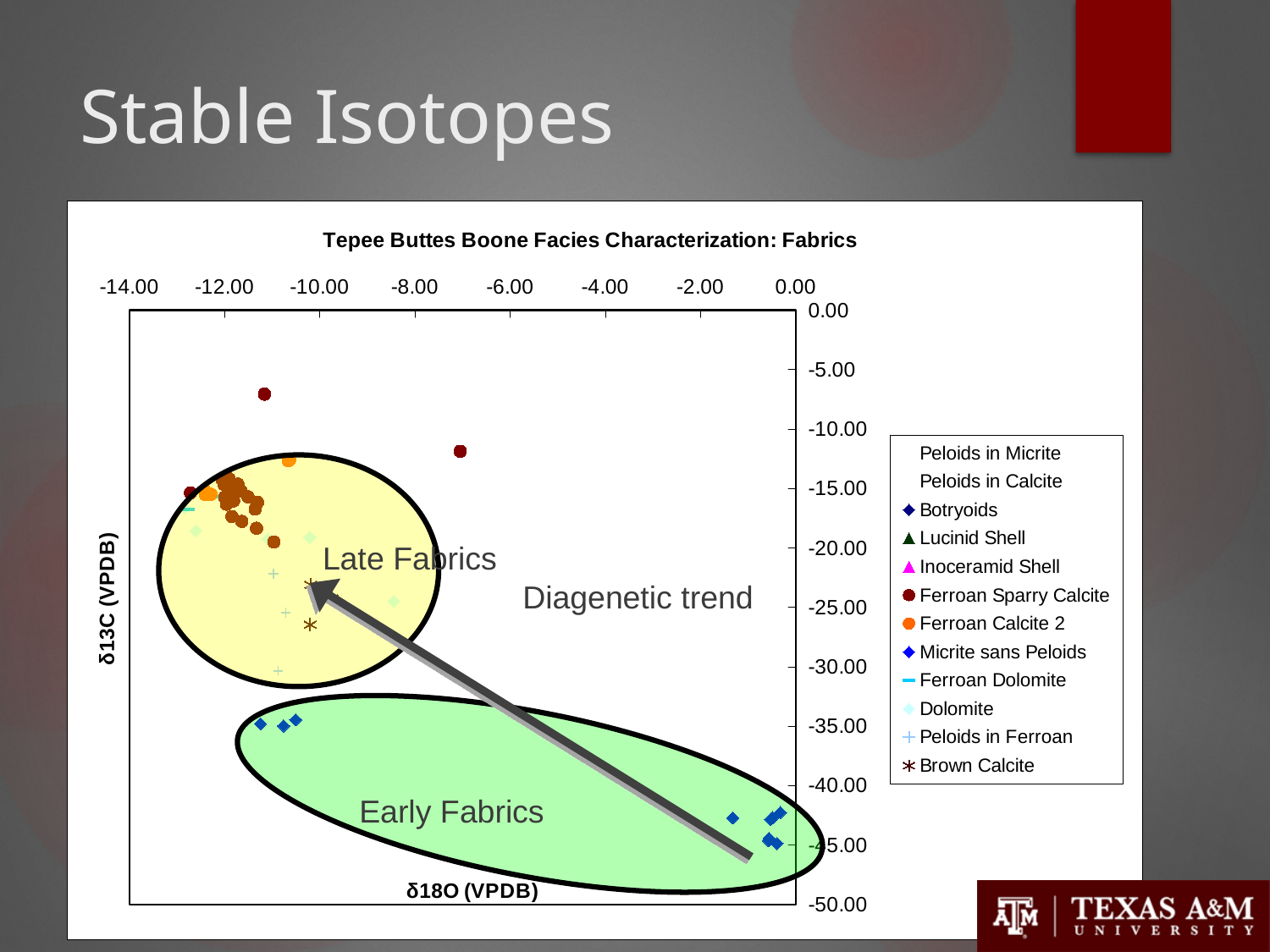
Are the δ18O values of the Brown Calcite points greater or less than -8.00? less What is the title of the chart? Tepee Buttes Boone Facies Characterization: Fabrics Which series has the point with the highest δ13C value on the chart? Ferroan Sparry Calcite Which series has higher δ13C values, Ferroan Sparry Calcite or Micrite sans Peloids? Ferroan Sparry Calcite Following the diagenetic trend arrow, do δ13C values rise or fall as δ18O increases toward 0.00? fall Are the δ13C values of the Brown Calcite points greater or less than -20.00? less What kind of chart is shown on the slide? Scatter chart Is the δ13C value of the highest Ferroan Sparry Calcite point greater or less than -10.00? greater Which series has the points with the lowest δ13C values on the chart? Micrite sans Peloids How many series does the chart legend list? 12 What is the label of the vertical axis of the chart? δ13C (VPDB)